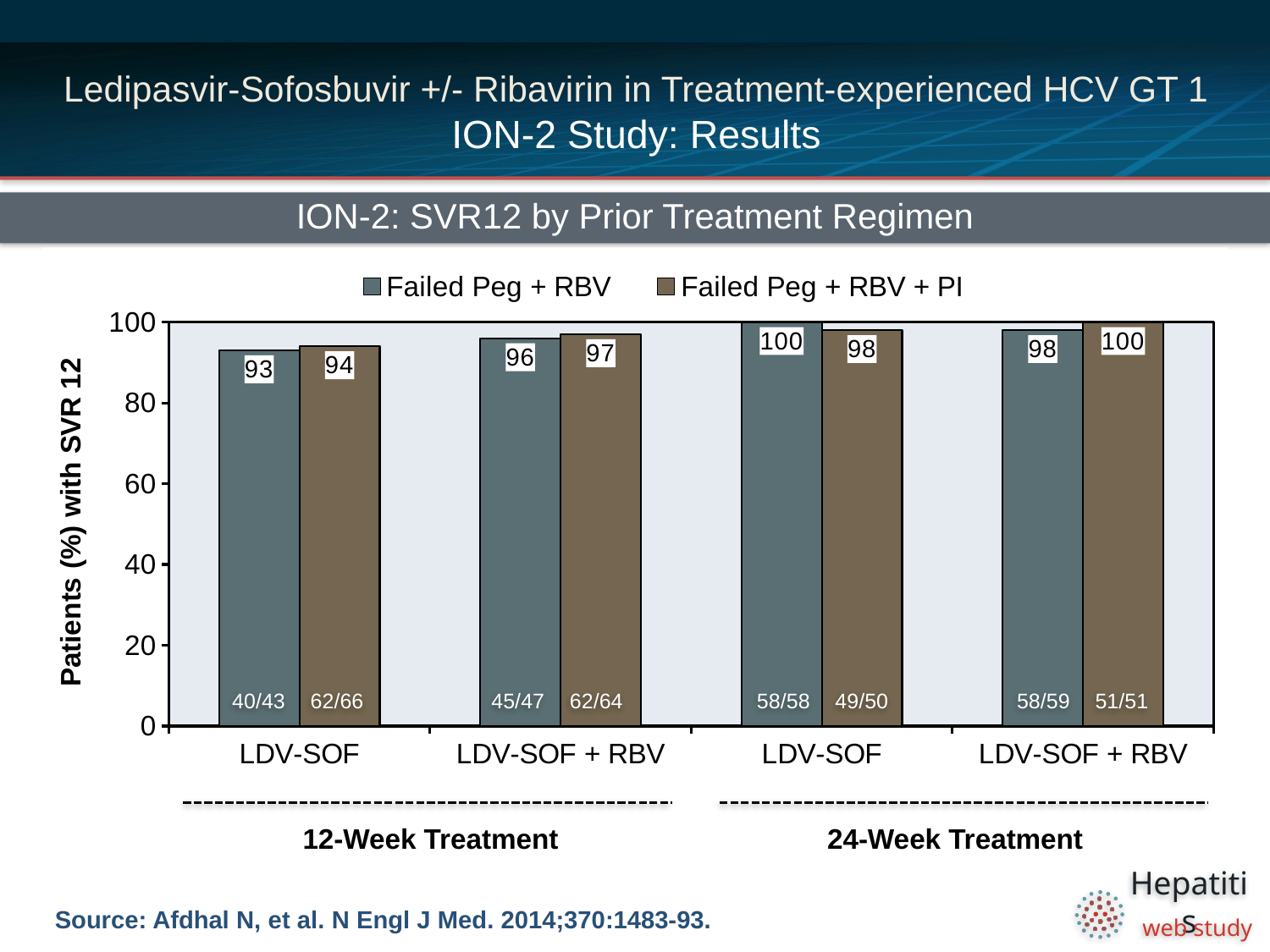
What is the SVR12 rate for the Failed Peg + RBV + PI group with LDV-SOF + RBV in the 12-week treatment arm? 97 What is the title of the chart? ION-2: SVR12 by Prior Treatment Regimen What is the SVR12 rate for the Failed Peg + RBV group with LDV-SOF in the 12-week treatment arm? 93 What is the SVR12 rate for the Failed Peg + RBV group with LDV-SOF in the 24-week treatment arm? 100 What kind of chart is shown on the slide? Bar chart What is the SVR12 rate for the Failed Peg + RBV + PI group with LDV-SOF + RBV in the 24-week treatment arm? 100 How many treatment regimen categories are shown on the x axis? 4 What is the difference in SVR12 rate between the Failed Peg + RBV + PI group and the Failed Peg + RBV group for LDV-SOF + RBV in the 12-week arm? 1 Which 12-week treatment regimen has the lowest SVR12 rate for the Failed Peg + RBV group? LDV-SOF What is the label of the y axis? Patients (%) with SVR 12 How many series does the legend list? 2 In the 24-week LDV-SOF arm, which group has the higher SVR12 rate: Failed Peg + RBV or Failed Peg + RBV + PI? Failed Peg + RBV